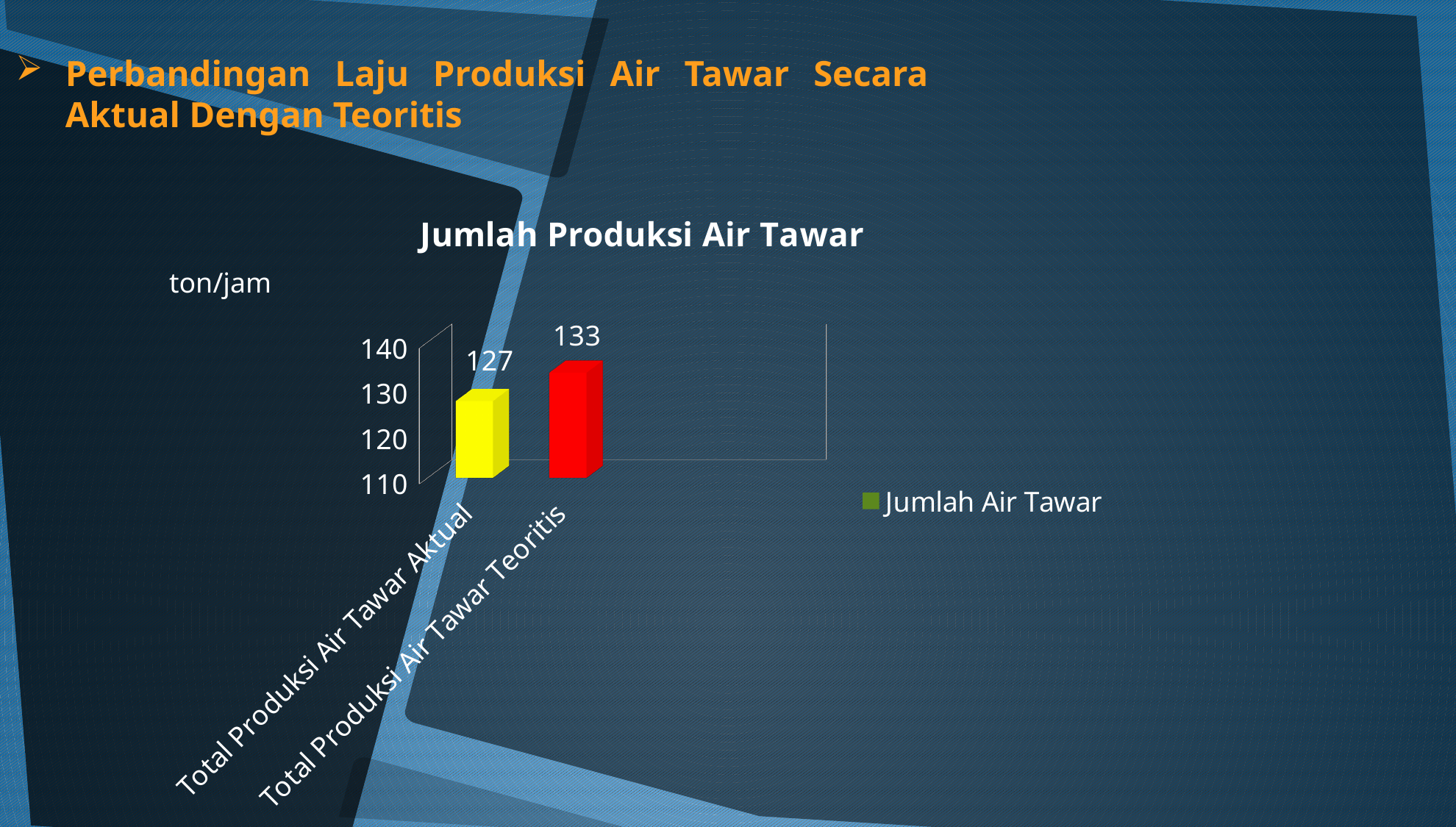
What kind of chart is shown? bar chart How many categories are shown in the chart? 2 Which category has the lowest value? Total Produksi Air Tawar Aktual How many series does the legend list? 1 Which is larger, the value for Total Produksi Air Tawar Aktual or Total Produksi Air Tawar Teoritis? Total Produksi Air Tawar Teoritis What is the value for Total Produksi Air Tawar Teoritis? 133 What is the title of the chart? Jumlah Produksi Air Tawar Is the value for Total Produksi Air Tawar Teoritis greater or less than 130? greater What is the value for Total Produksi Air Tawar Aktual? 127 Which category has the highest value? Total Produksi Air Tawar Teoritis Is the value for Total Produksi Air Tawar Aktual greater or less than 130? less What is the difference between the Teoritis and Aktual values? 6